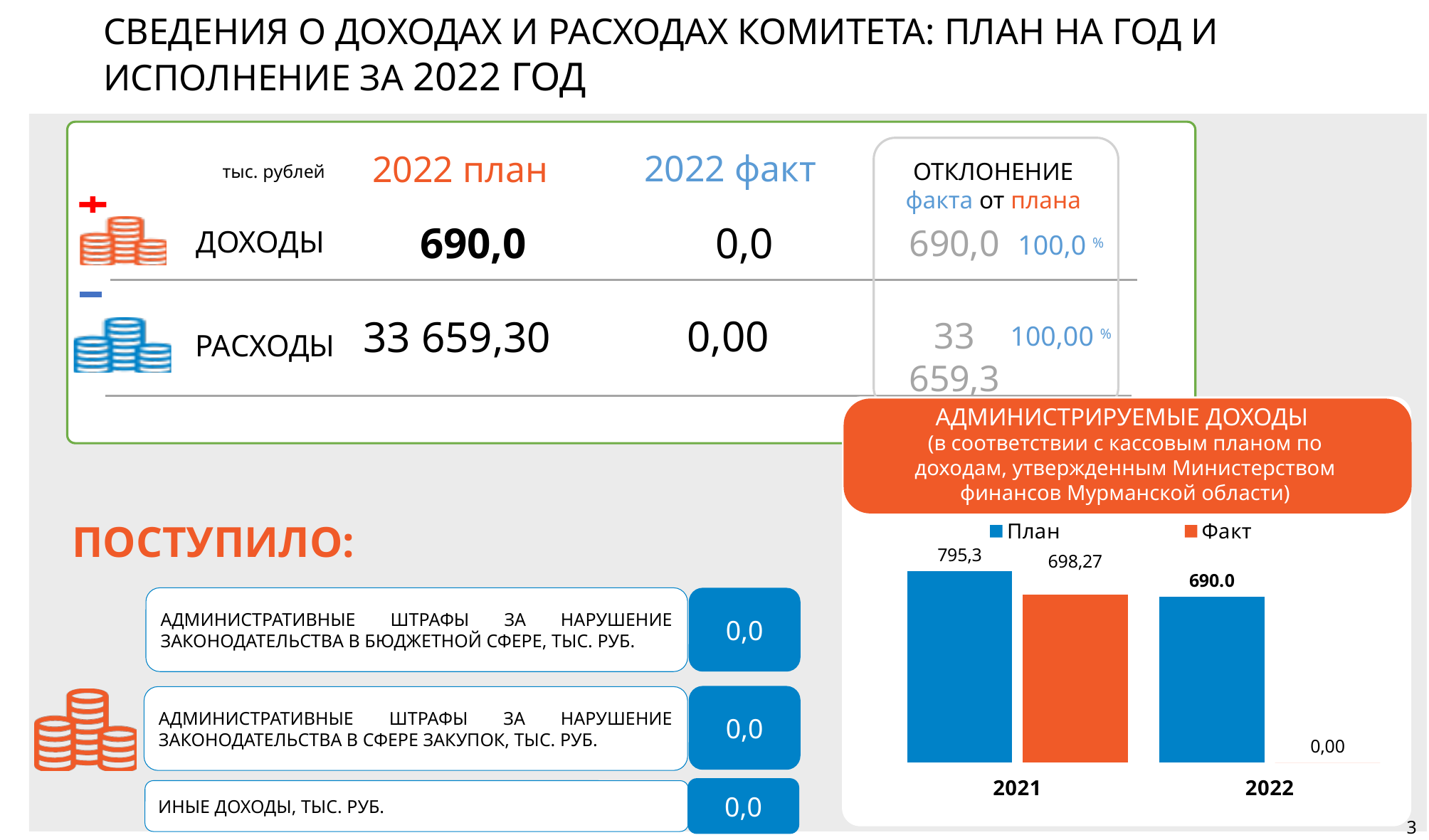
In the «АДМИНИСТРИРУЕМЫЕ ДОХОДЫ» chart, what is the План value for 2022? 690.0 In the «АДМИНИСТРИРУЕМЫЕ ДОХОДЫ» chart, which bar has the lowest value? Факт 2022 How many series does the legend of the «АДМИНИСТРИРУЕМЫЕ ДОХОДЫ» chart list? 2 In the «АДМИНИСТРИРУЕМЫЕ ДОХОДЫ» chart, which bar has the highest value? План 2021 In the «АДМИНИСТРИРУЕМЫЕ ДОХОДЫ» chart, what is the Факт value for 2021? 698,27 What type of chart is shown under the heading «АДМИНИСТРИРУЕМЫЕ ДОХОДЫ»? bar chart In the «АДМИНИСТРИРУЕМЫЕ ДОХОДЫ» chart, does the План value rise or fall from 2021 to 2022? fall How many years (categories) are shown on the x axis of the «АДМИНИСТРИРУЕМЫЕ ДОХОДЫ» chart? 2 What are the two series named in the legend of the «АДМИНИСТРИРУЕМЫЕ ДОХОДЫ» chart? План and Факт In the «АДМИНИСТРИРУЕМЫЕ ДОХОДЫ» chart, what is the План value for 2021? 795,3 In the «АДМИНИСТРИРУЕМЫЕ ДОХОДЫ» chart, what is the Факт value for 2022? 0,00 In the «АДМИНИСТРИРУЕМЫЕ ДОХОДЫ» chart, what is the difference between the План and Факт values for 2021? 97,03